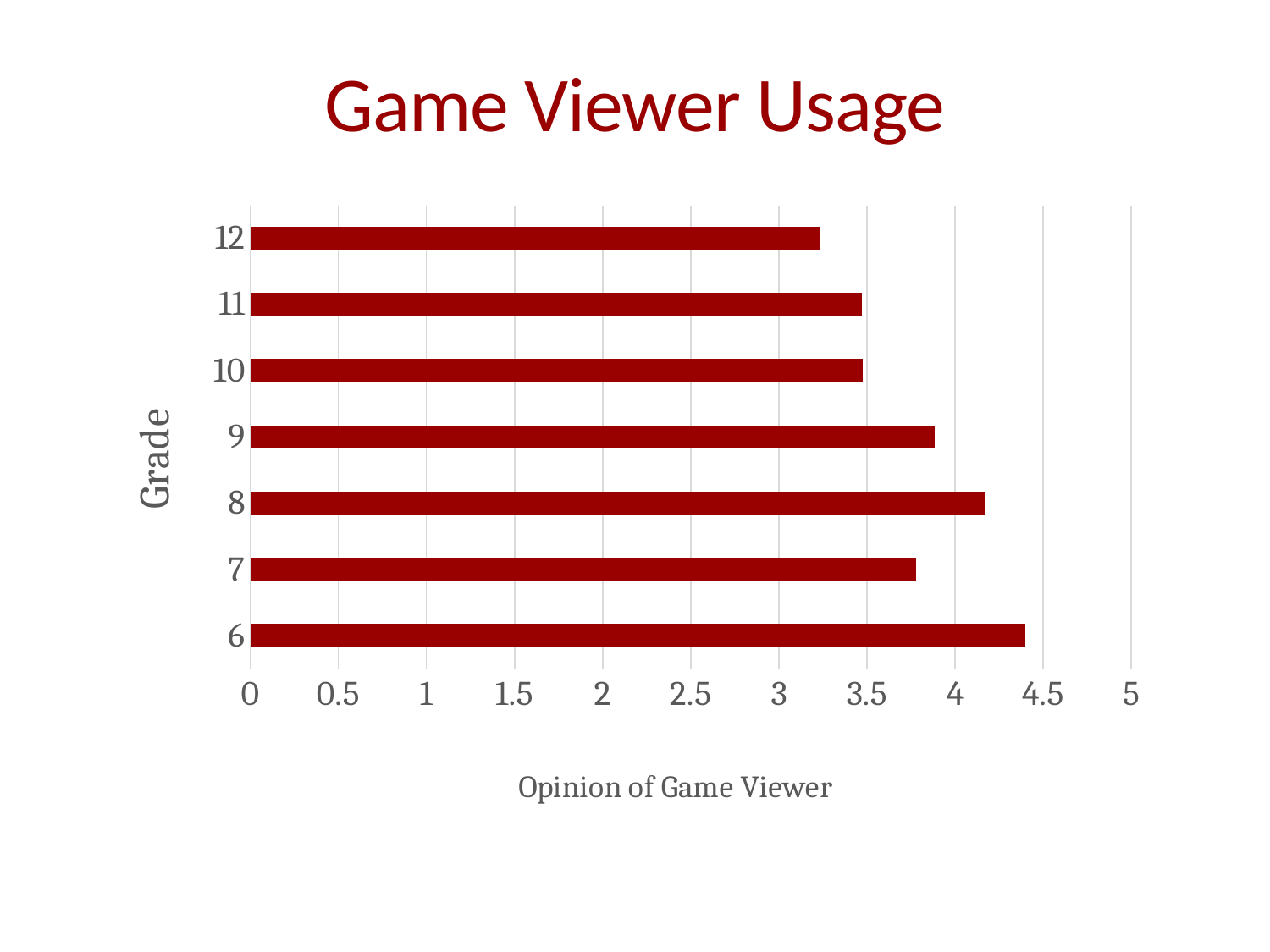
Is the value for grade 9 greater or less than 4? less What is the label of the horizontal axis? Opinion of Game Viewer What is the title of the chart? Game Viewer Usage Is the value for grade 6 greater or less than 4? greater Which grade has a higher value, grade 8 or grade 9? 8 Is the value for grade 7 greater or less than 4? less Which grade has the lowest opinion of Game Viewer? 12 How many grades are plotted in the chart? 7 Which grade has a higher value, grade 7 or grade 12? 7 Which grade has the highest opinion of Game Viewer? 6 What kind of chart is shown on the slide? bar chart